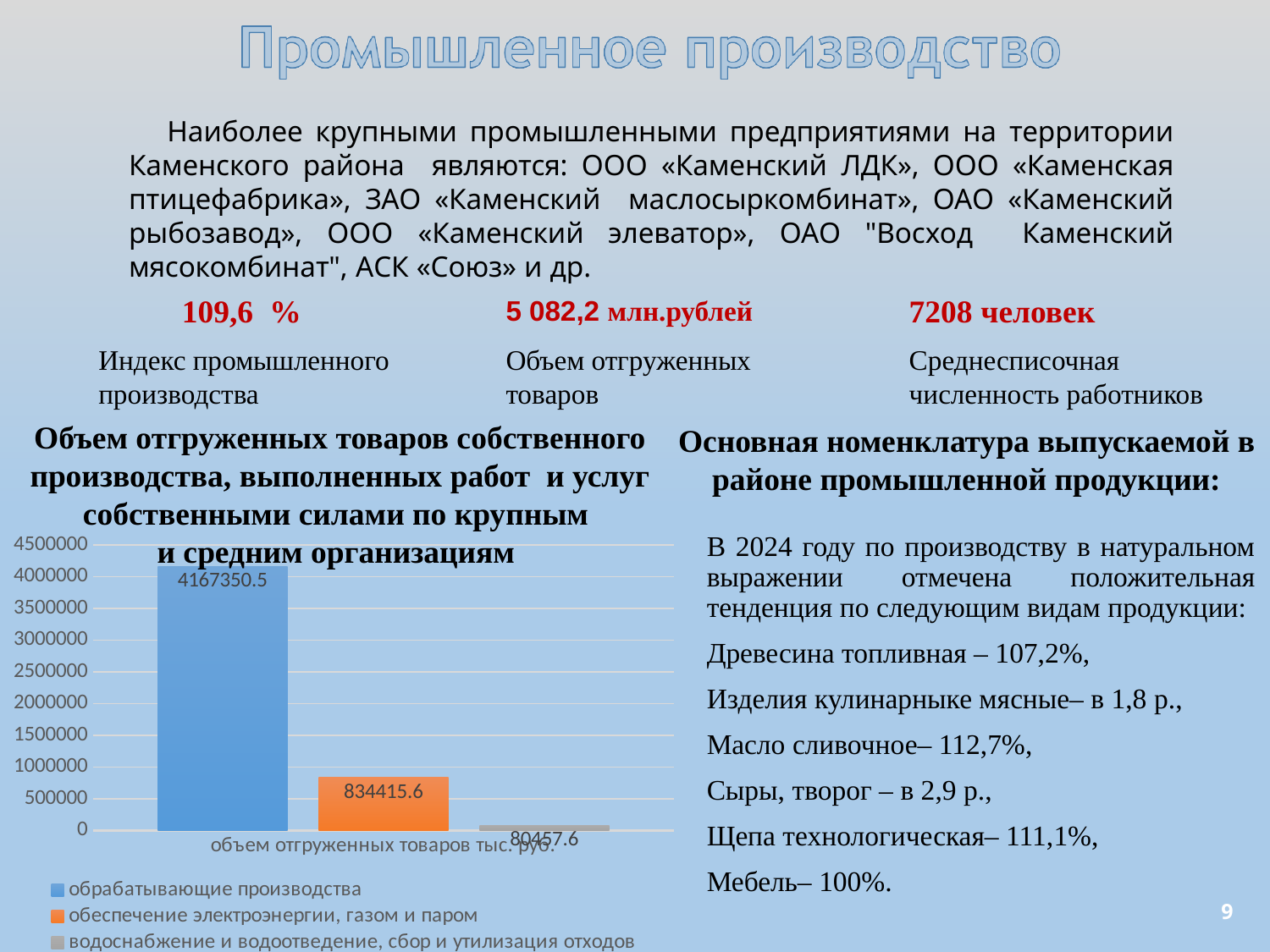
What is the value for водоснабжение и водоотведение, сбор и утилизация отходов? 80457.6 How many series does the chart legend list? 3 Which series has the highest value? обрабатывающие производства Which series has the lowest value? водоснабжение и водоотведение, сбор и утилизация отходов Is the value for обрабатывающие производства greater or less than 4000000? greater What is the value for обрабатывающие производства? 4167350.5 What colour is the bar for обеспечение электроэнергии, газом и паром? orange What is the difference between the values for обрабатывающие производства and обеспечение электроэнергии, газом и паром? 3332934.9 What is the value for обеспечение электроэнергии, газом и паром? 834415.6 What is the category label shown on the x axis of the chart? объем отгруженных товаров тыс. руб. What type of chart is shown on the slide? bar chart Which is larger: the value for обеспечение электроэнергии, газом и паром or the value for водоснабжение и водоотведение, сбор и утилизация отходов? обеспечение электроэнергии, газом и паром